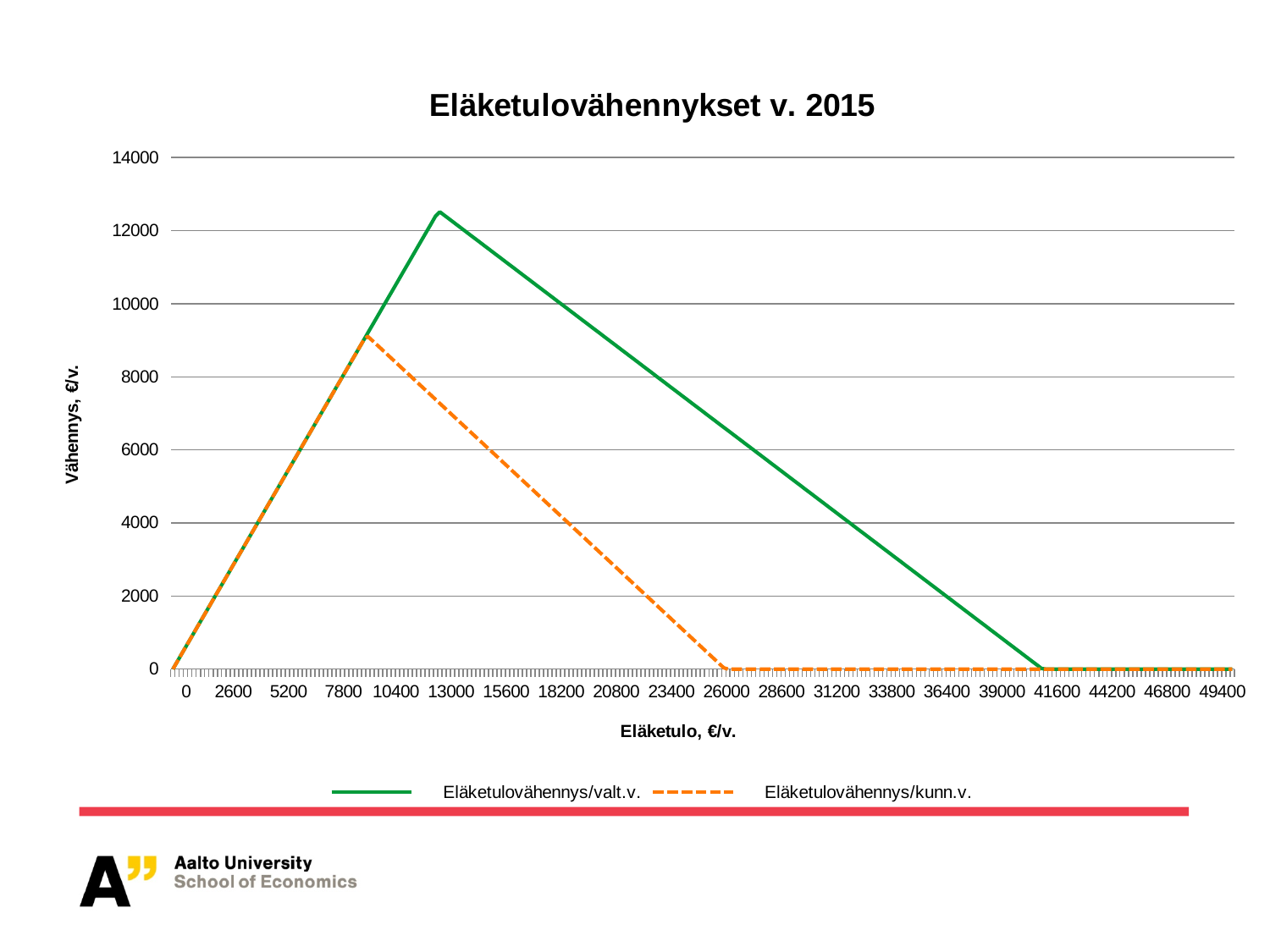
What kind of chart is shown on the slide? line chart Is the value of Eläketulovähennys/valt.v. at Eläketulo 33800 greater or less than 4000? less What is the value of Eläketulovähennys/valt.v. at Eläketulo 0? 0 Is the peak value of Eläketulovähennys/valt.v. greater or less than 12000? greater Is the peak value of Eläketulovähennys/kunn.v. greater or less than 10000? less What is the title of the chart? Eläketulovähennykset v. 2015 How many series does the legend list? 2 What is the value of Eläketulovähennys/kunn.v. at Eläketulo 49400? 0 What is the label of the y axis? Vähennys, €/v. Which series reaches its peak at a higher Eläketulo value, Eläketulovähennys/valt.v. or Eläketulovähennys/kunn.v.? Eläketulovähennys/valt.v. At Eläketulo 20800, which series has the higher value, Eläketulovähennys/valt.v. or Eläketulovähennys/kunn.v.? Eläketulovähennys/valt.v.